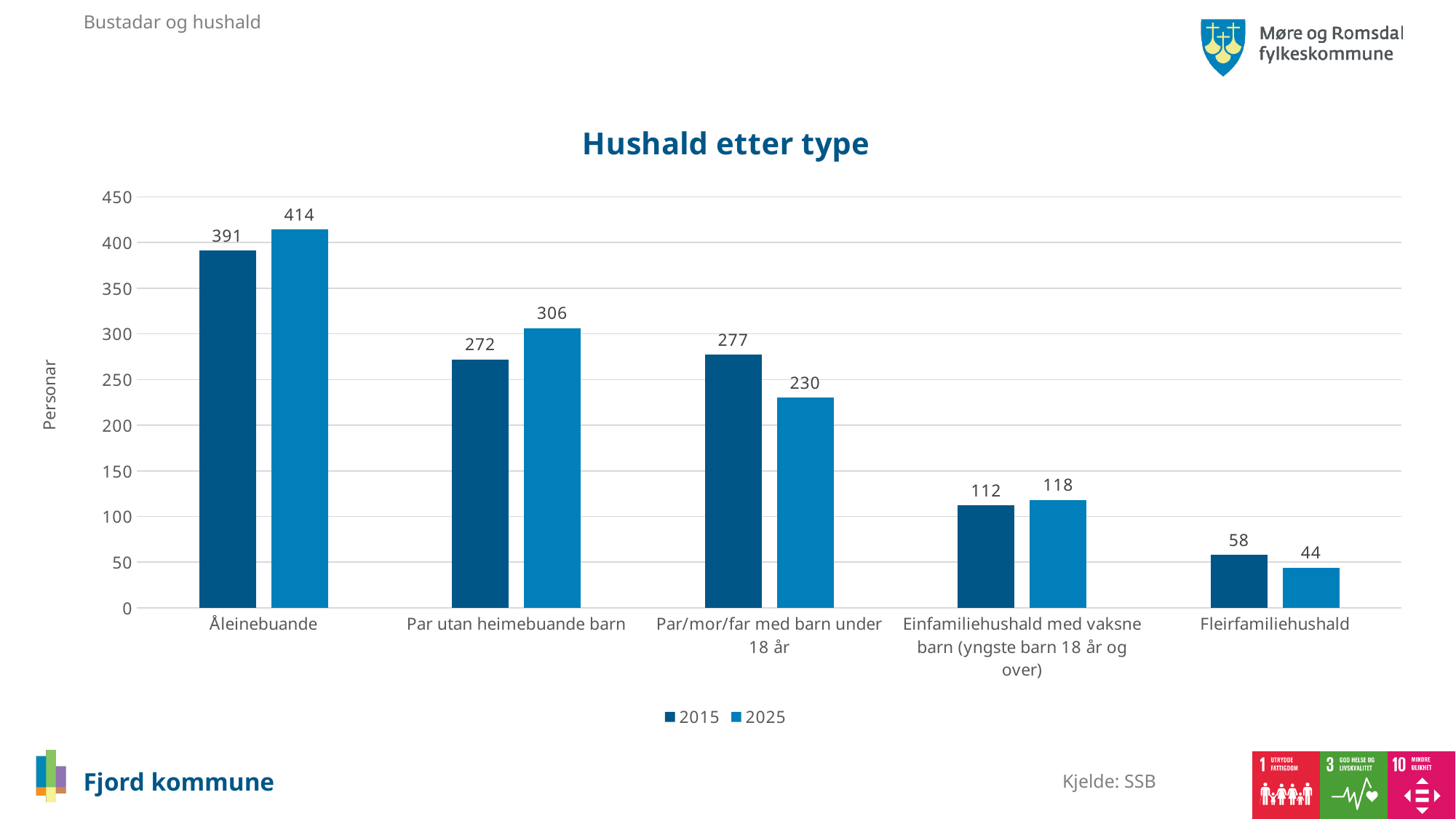
What is the title of the chart? Hushald etter type What is the label on the y axis? Personar How many series does the legend list? 2 What is the 2015 value for Åleinebuande? 391 Which category has the lowest 2015 value? Fleirfamiliehushald What kind of chart is shown? Bar chart Which is larger for Par/mor/far med barn under 18 år: the 2015 value or the 2025 value? 2015 What is the 2025 value for Par/mor/far med barn under 18 år? 230 How many household categories are shown on the x axis? 5 What is the 2025 value for Fleirfamiliehushald? 44 What is the difference between the 2025 and 2015 values for Par utan heimebuande barn? 34 Which category has the highest 2025 value? Åleinebuande